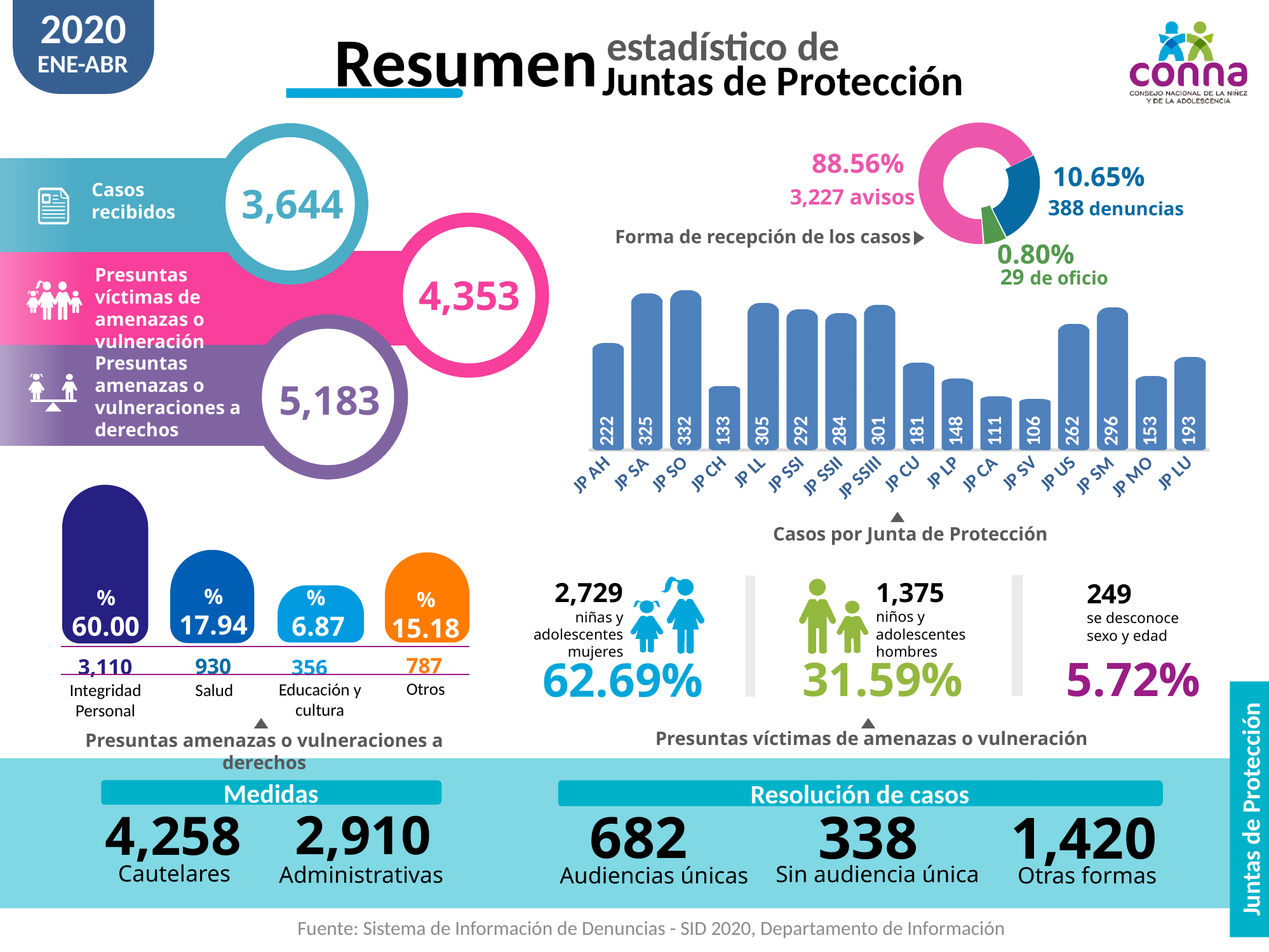
What kind of chart is 'Casos por Junta de Protección'? Bar chart In the 'Casos por Junta de Protección' chart, which Junta has the lowest number of cases? JP SV In the 'Forma de recepción de los casos' donut chart, how many cases were denuncias? 388 In the 'Casos por Junta de Protección' chart, which Junta has the highest number of cases? JP SO In the 'Casos por Junta de Protección' chart, which has more cases, JP US or JP CU? JP US In the 'Presuntas amenazas o vulneraciones a derechos' chart, which category has the lowest percentage? Educación y cultura How many Juntas de Protección are shown in the 'Casos por Junta de Protección' chart? 16 In the 'Forma de recepción de los casos' donut chart, what percentage of cases were received as avisos? 88.56% In the 'Presuntas amenazas o vulneraciones a derechos' chart, what is the difference between the values for Integridad Personal and Otros? 2,323 In the 'Casos por Junta de Protección' chart, what is the value for JP SSIII? 301 In the 'Presuntas amenazas o vulneraciones a derechos' chart, what is the value for Salud? 930 In the 'Casos por Junta de Protección' chart, what is the difference between the values for JP SA and JP CH? 192